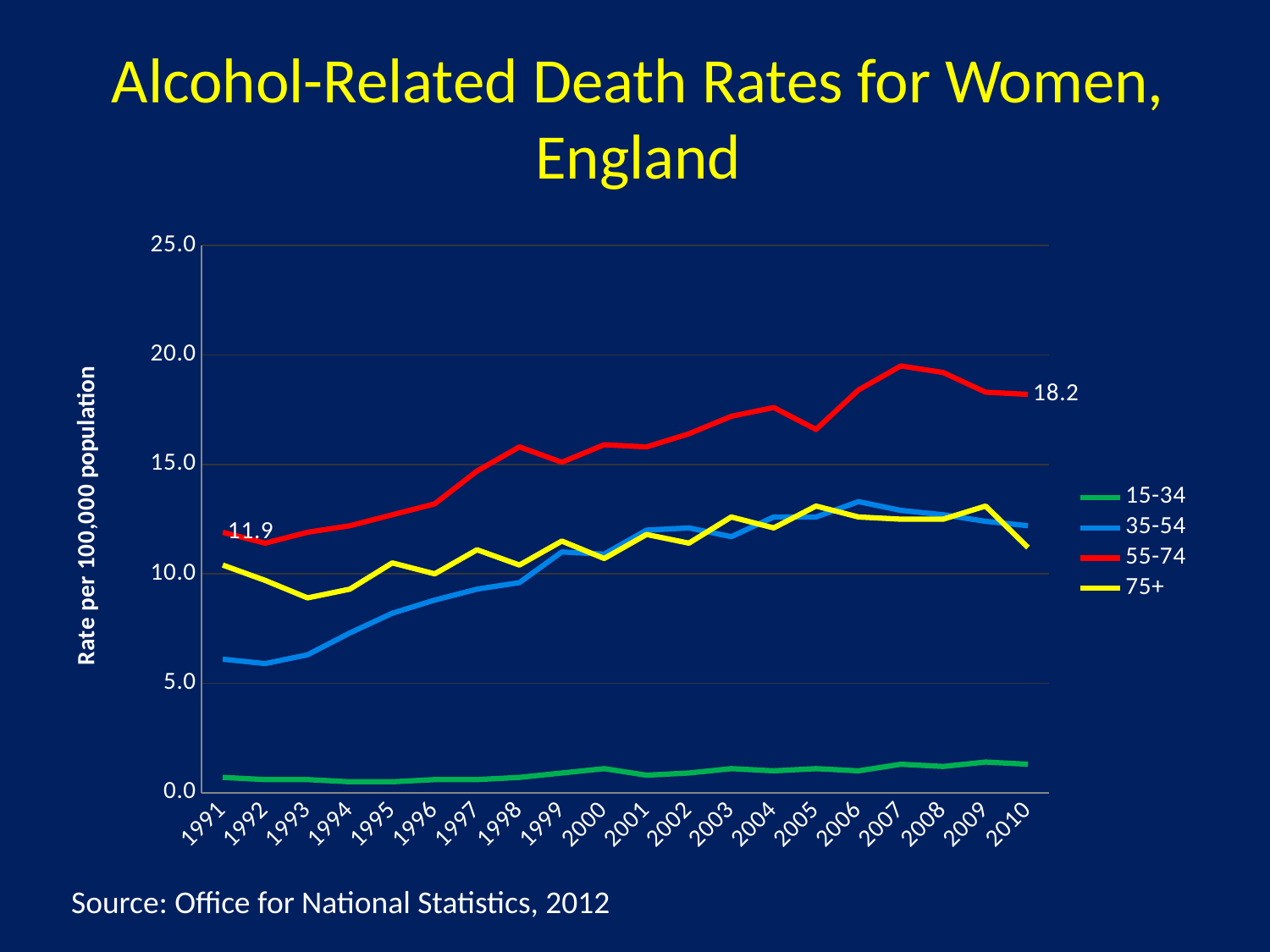
What is the alcohol-related death rate for the 55-74 age group in 1991? 11.9 Does the death rate for the 55-74 age group rise or fall overall from 1991 to 2010? Rise What kind of chart is shown on the slide? Line chart What is the alcohol-related death rate for the 55-74 age group in 2010? 18.2 Which age group has the lowest death rate throughout the period? 15-34 Which age group has the highest death rate in 2010? 55-74 How many years are shown along the x axis? 20 How many age groups does the legend list? 4 Is the death rate for the 35-54 age group in 1991 greater or less than 10.0? less What is the label on the vertical axis? Rate per 100,000 population Is the death rate for the 55-74 age group in 2007 greater or less than 15.0? greater By how much did the death rate for the 55-74 age group increase between 1991 and 2010? 6.3